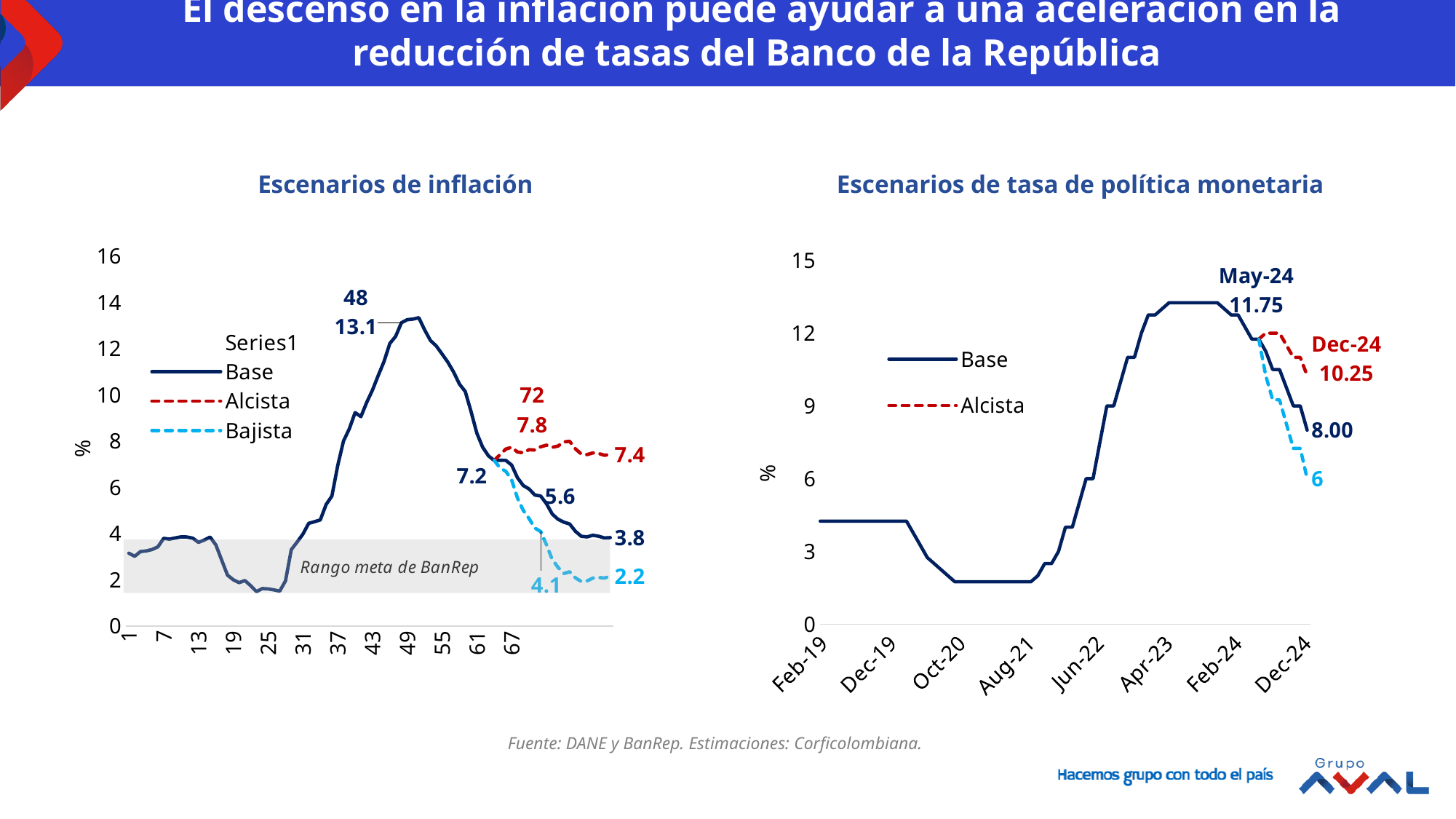
In the "Escenarios de tasa de política monetaria" chart, what is the labelled Dec-24 value of the Alcista scenario? 10.25 In the "Escenarios de tasa de política monetaria" chart, what is the final labelled value of the Base line? 8.00 In the "Escenarios de inflación" chart, which scenario ends higher, Alcista or Bajista? Alcista In the "Escenarios de inflación" chart, what is the final labelled value of the Bajista scenario? 2.2 In the "Escenarios de inflación" chart, what is the final labelled value of the Base scenario? 3.8 In the "Escenarios de inflación" chart, what is the difference between the final Alcista value and the final Base value? 3.6 How many series does the legend of the "Escenarios de tasa de política monetaria" chart list? 2 In the "Escenarios de tasa de política monetaria" chart, is the Base value at Oct-20 greater or less than 3? less In the "Escenarios de inflación" chart, what is the final labelled value of the Alcista scenario? 7.4 In the "Escenarios de inflación" chart, what is the labelled peak value of the Base line? 13.1 In the "Escenarios de tasa de política monetaria" chart, what is the labelled value for May-24? 11.75 What kind of chart is "Escenarios de inflación"? line chart